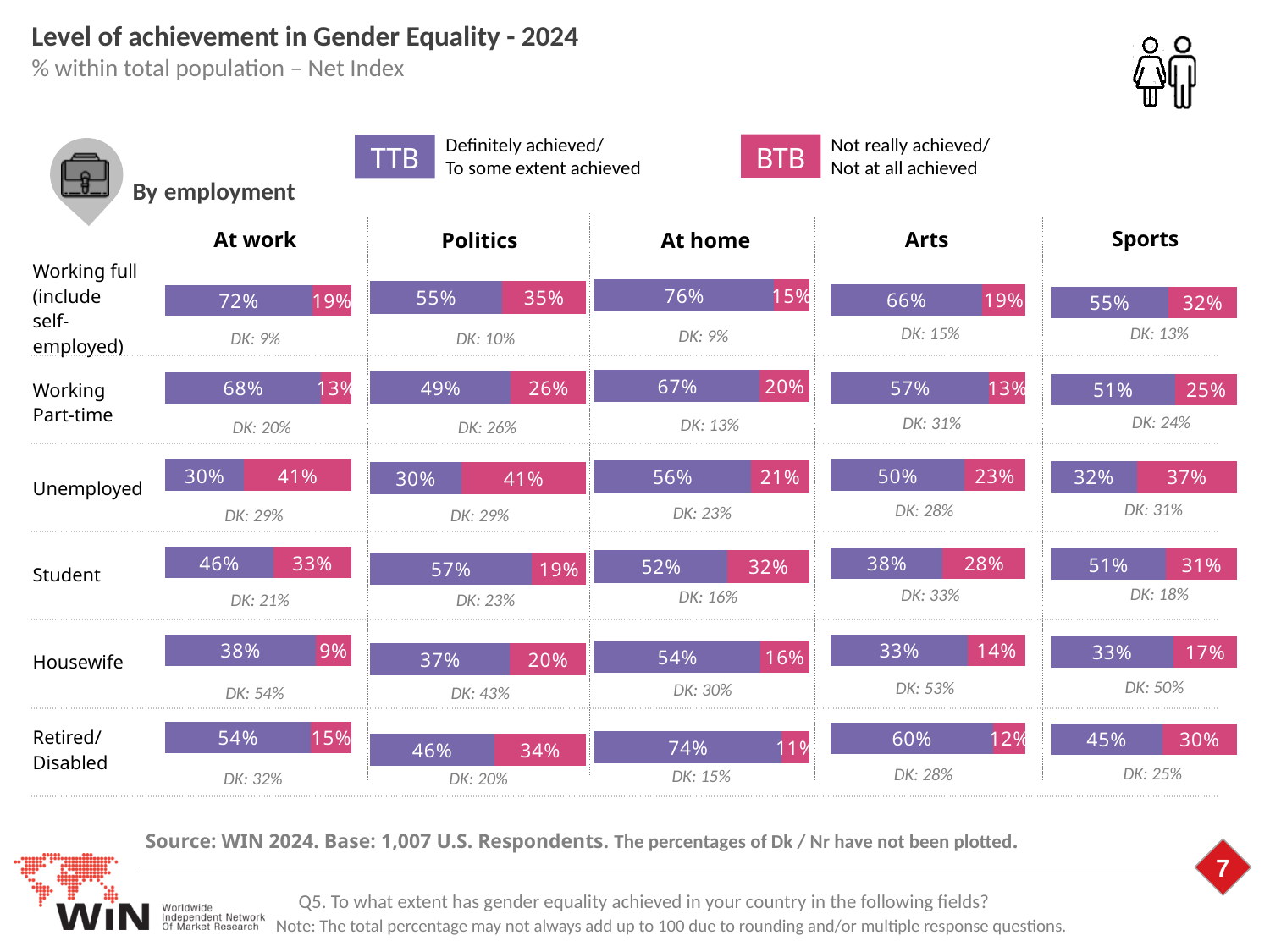
In the 'At work' chart, which is larger: the TTB value for Student or the TTB value for Housewife? Student In the 'Arts' chart, which employment group has the lowest TTB value? Housewife In the 'At work' chart, what is the TTB value for Working full (include self-employed)? 72% In the 'Sports' chart, what is the difference between the TTB and BTB values for Working full (include self-employed)? 23 percentage points In the 'At home' chart, which employment group has the highest TTB value? Working full (include self-employed) In the 'At work' chart, what is the DK percentage noted for Housewife? DK: 54% In the 'At work' chart, what is the combined total of the TTB and BTB values for Unemployed? 71% How many employment groups are shown in each chart? 6 In the 'Politics' chart, what is the BTB value for Unemployed? 41% Which colour represents BTB (Not really achieved / Not at all achieved) in the charts? Pink How many series does the legend list? 2 What kind of chart is used to show the results for each field? Stacked bar chart